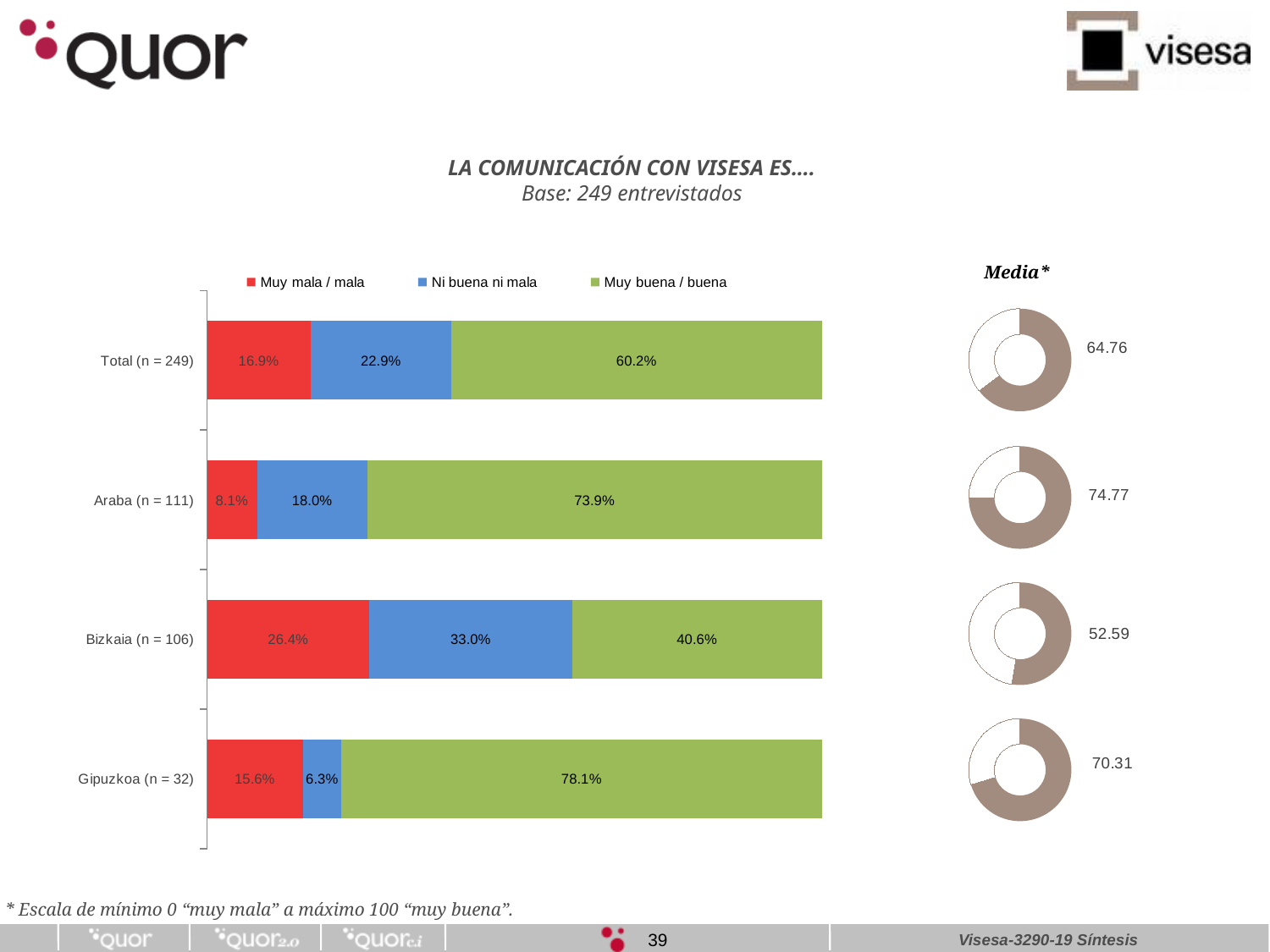
In the Media* donut charts, what is the mean value shown for Bizkaia (n = 106)? 52.59 In the Media* donut charts, which category has the highest mean value? Araba (n = 111) How many series does the legend of the stacked bar chart list? 3 In the stacked bar chart, what percentage of Araba (n = 111) respondents rated communication as 'Muy buena / buena'? 73.9% What kind of chart is used to show the 'Muy mala / mala', 'Ni buena ni mala' and 'Muy buena / buena' breakdown? Stacked bar chart In the stacked bar chart, what is the difference between the 'Muy buena / buena' values for Araba (n = 111) and Bizkaia (n = 106)? 33.3 percentage points How many categories are shown in the stacked bar chart? 4 In the stacked bar chart, what is the 'Ni buena ni mala' value for Bizkaia (n = 106)? 33.0% In the stacked bar chart, what is the 'Muy mala / mala' value for Total (n = 249)? 16.9% In the stacked bar chart, which is larger: the 'Ni buena ni mala' value for Total (n = 249) or for Gipuzkoa (n = 32)? Total (n = 249) In the stacked bar chart, which category has the lowest 'Muy mala / mala' percentage? Araba (n = 111) In the stacked bar chart, which category has the highest 'Muy buena / buena' percentage? Gipuzkoa (n = 32)